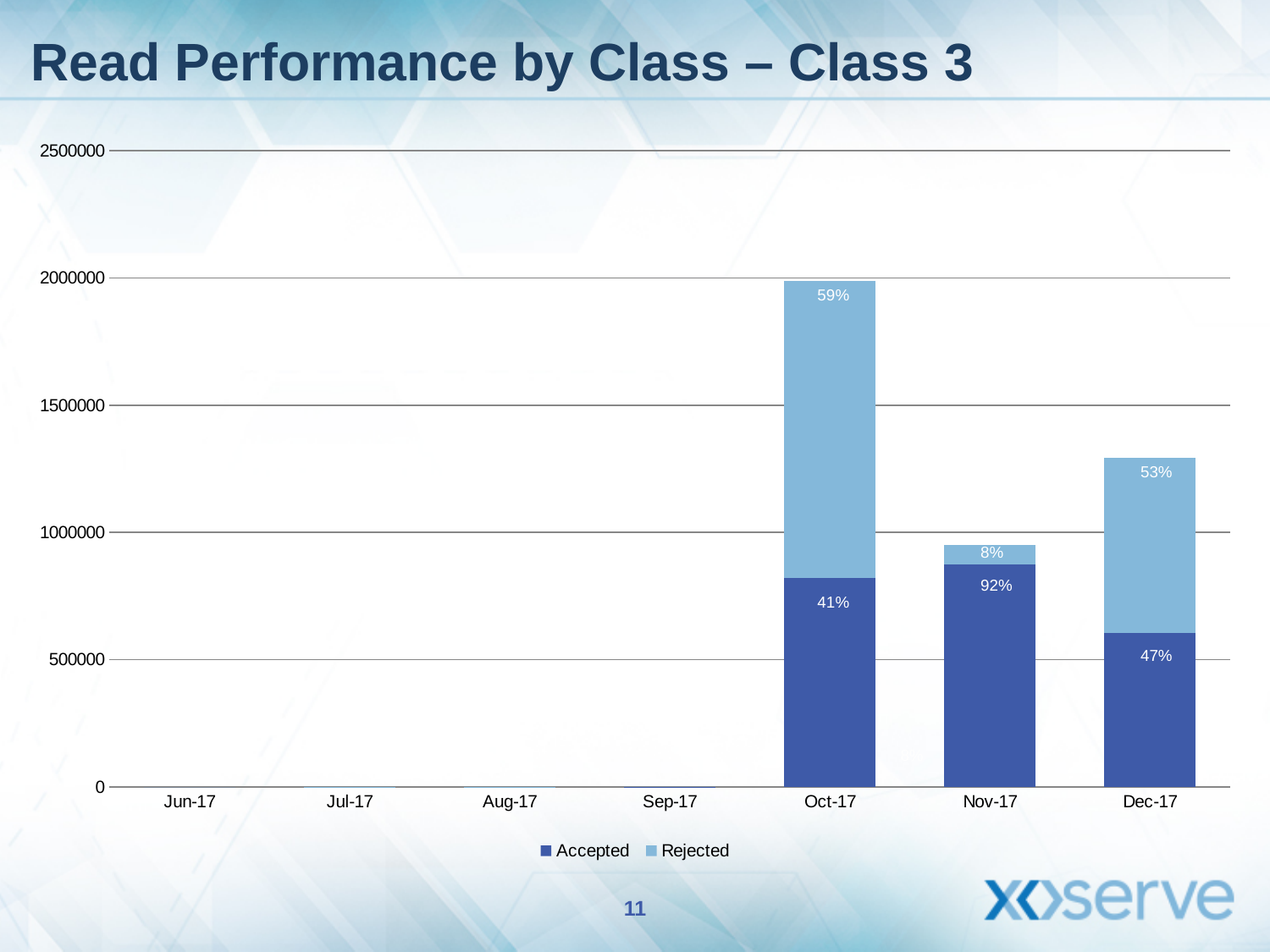
What percentage label is shown on the Rejected segment for Nov-17? 8% What percentage label is shown on the Accepted segment for Dec-17? 47% How many series does the legend list? 2 How many months are shown on the x axis? 7 What percentage label is shown on the Rejected segment for Oct-17? 59% Which bar is taller, Nov-17 or Dec-17? Dec-17 What type of chart is shown on the slide? Stacked bar chart In Oct-17, by how many percentage points does the Rejected share exceed the Accepted share? 18 percentage points Is the total bar height for Nov-17 greater or less than 1000000? less What percentage label is shown on the Accepted segment for Nov-17? 92% Which month has the tallest bar? Oct-17 Is the total bar height for Dec-17 greater or less than 1000000? greater